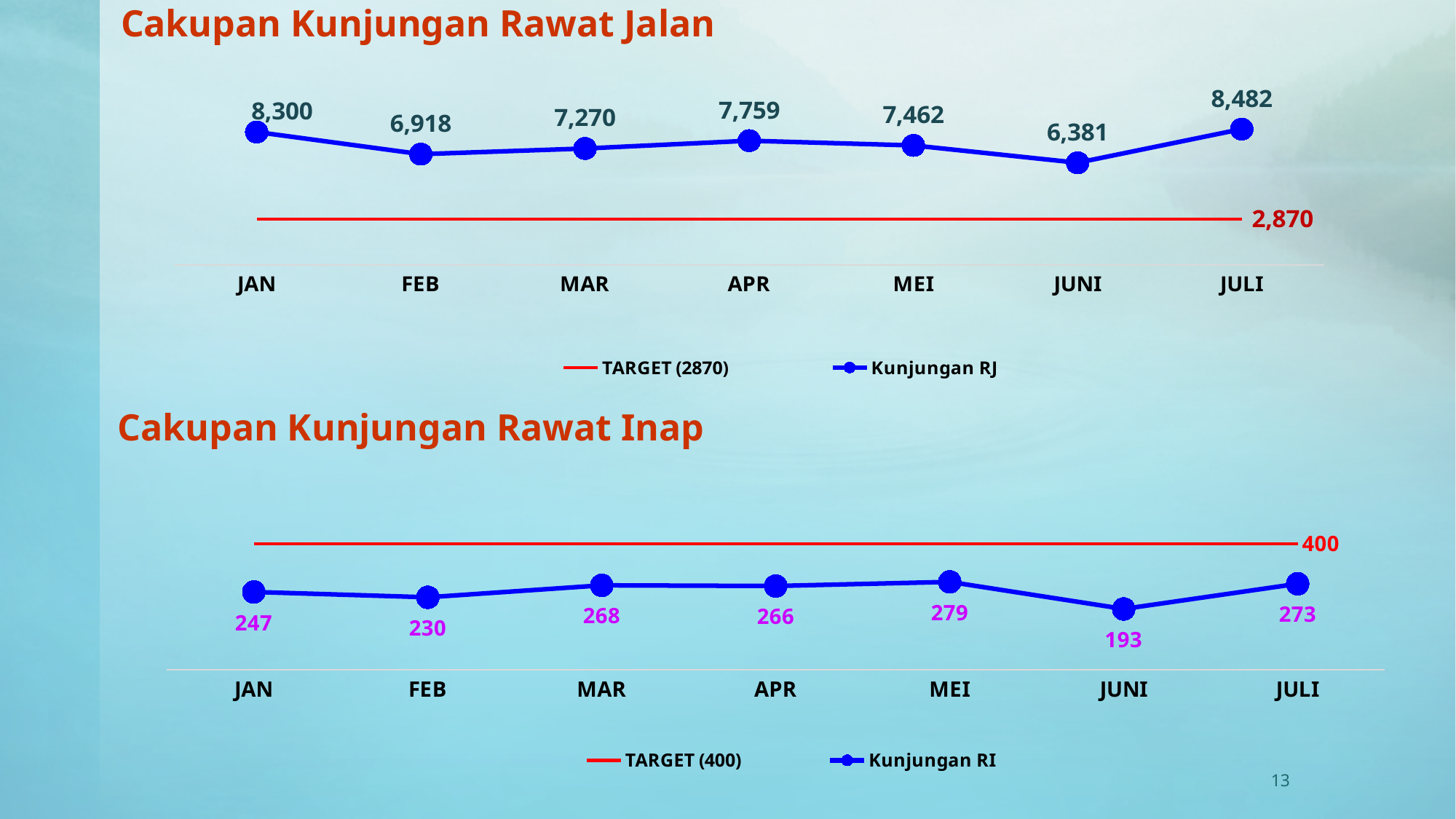
In the 'Cakupan Kunjungan Rawat Jalan' chart, which month has the highest Kunjungan RJ value? JULI In the 'Cakupan Kunjungan Rawat Jalan' chart, how many series does the legend list? 2 In the 'Cakupan Kunjungan Rawat Jalan' chart, which month has the lowest Kunjungan RJ value? JUNI In the 'Cakupan Kunjungan Rawat Jalan' chart, what is the difference between the Kunjungan RJ values for JULI and JUNI? 2,101 In the 'Cakupan Kunjungan Rawat Inap' chart, how many months are plotted on the x axis? 7 In the 'Cakupan Kunjungan Rawat Inap' chart, what is the difference between the Kunjungan RI values for JAN and FEB? 17 In the 'Cakupan Kunjungan Rawat Inap' chart, what is the Kunjungan RI value for MEI? 279 In the 'Cakupan Kunjungan Rawat Inap' chart, is the Kunjungan RI value for MAR larger than the value for APR? Yes, MAR (268) is larger than APR (266) In the 'Cakupan Kunjungan Rawat Inap' chart, which month has the lowest Kunjungan RI value? JUNI In the 'Cakupan Kunjungan Rawat Jalan' chart, what is the Kunjungan RJ value for JAN? 8,300 What kind of chart is the 'Cakupan Kunjungan Rawat Inap' chart? Line chart In the 'Cakupan Kunjungan Rawat Jalan' chart, what is the target value shown by the red line? 2,870